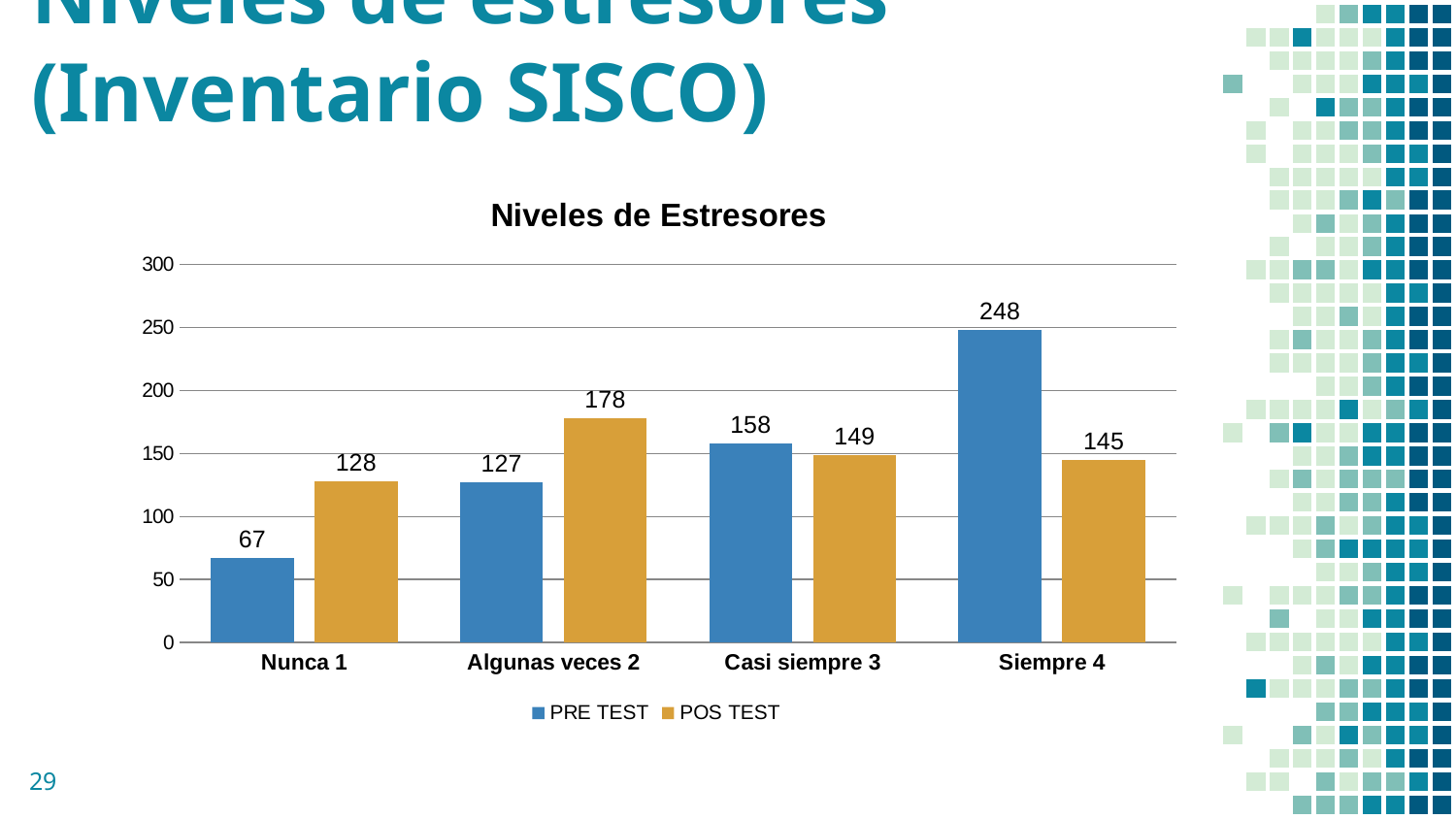
What is the PRE TEST value for Nunca 1? 67 What is the PRE TEST value for Siempre 4? 248 What is the POS TEST value for Algunas veces 2? 178 Which category has the highest PRE TEST value? Siempre 4 What is the POS TEST value for Casi siempre 3? 149 How many series does the legend list? 2 Which is larger for Algunas veces 2, the PRE TEST value or the POS TEST value? POS TEST What kind of chart is shown? Bar chart What is the title of the chart? Niveles de Estresores What is the difference between the PRE TEST and POS TEST values for Siempre 4? 103 How many categories are shown on the x axis? 4 Which category has the lowest POS TEST value? Nunca 1